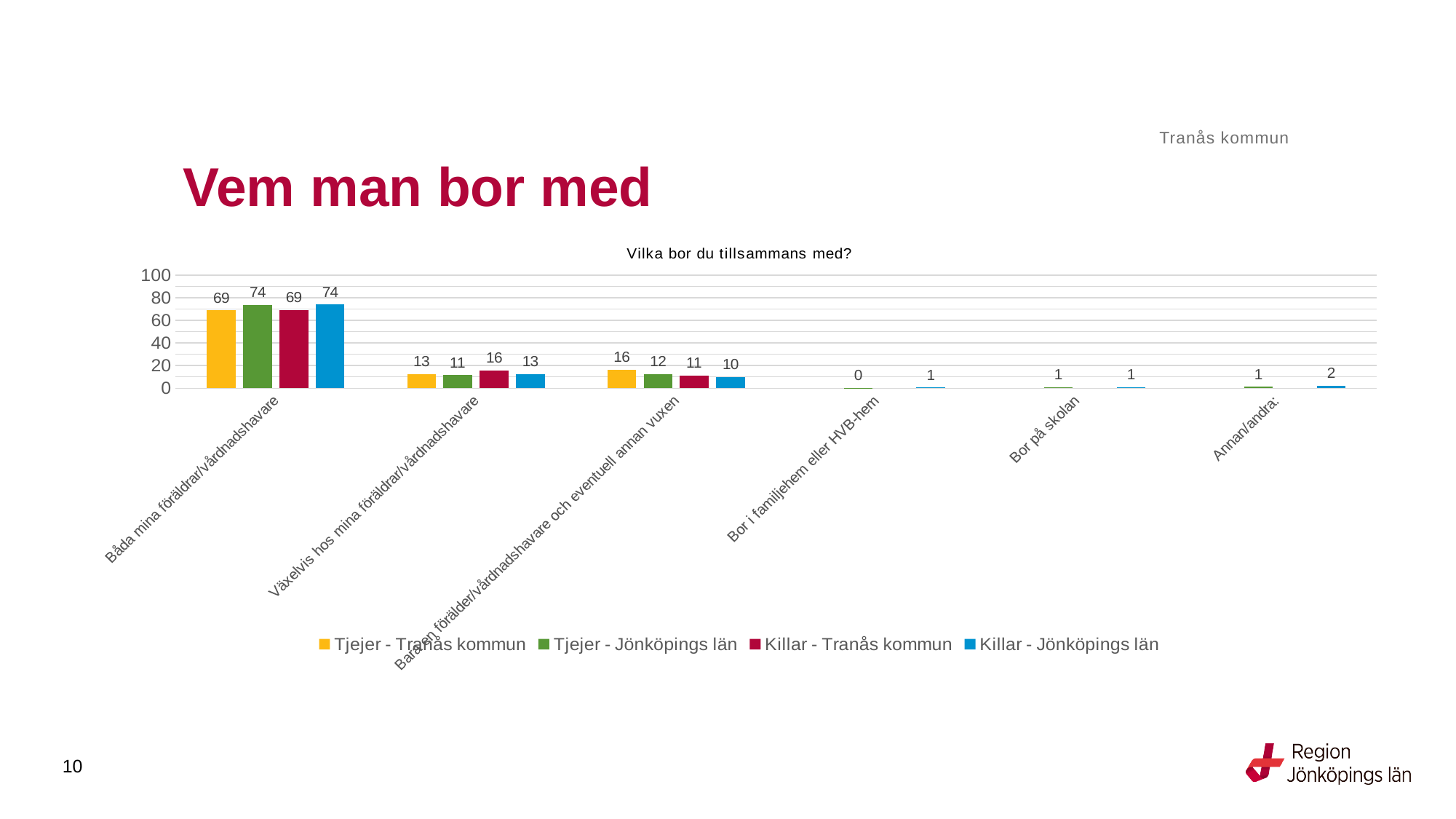
What is the title of the chart? Vilka bor du tillsammans med? In the category 'Växelvis hos mina föräldrar/vårdnadshavare', which is larger: Killar - Tranås kommun or Tjejer - Jönköpings län? Killar - Tranås kommun How many categories are shown on the x axis of the chart? 6 What is the value for Killar - Tranås kommun in the category 'Växelvis hos mina föräldrar/vårdnadshavare'? 16 How many series does the legend list? 4 What is the value for Killar - Jönköpings län in the category 'Annan/andra'? 2 Which category has the highest value for Killar - Jönköpings län? Båda mina föräldrar/vårdnadshavare In the category 'Båda mina föräldrar/vårdnadshavare', what is the difference between Tjejer - Jönköpings län and Tjejer - Tranås kommun? 5 What is the value for Tjejer - Jönköpings län in the category 'Båda mina föräldrar/vårdnadshavare'? 74 What is the value for Tjejer - Tranås kommun in the category 'Bara en förälder/vårdnadshavare och eventuell annan vuxen'? 16 Is the value for Killar - Jönköpings län in 'Båda mina föräldrar/vårdnadshavare' greater or less than 60? greater In the category 'Bara en förälder/vårdnadshavare och eventuell annan vuxen', what is the difference between Tjejer - Tranås kommun and Killar - Jönköpings län? 6